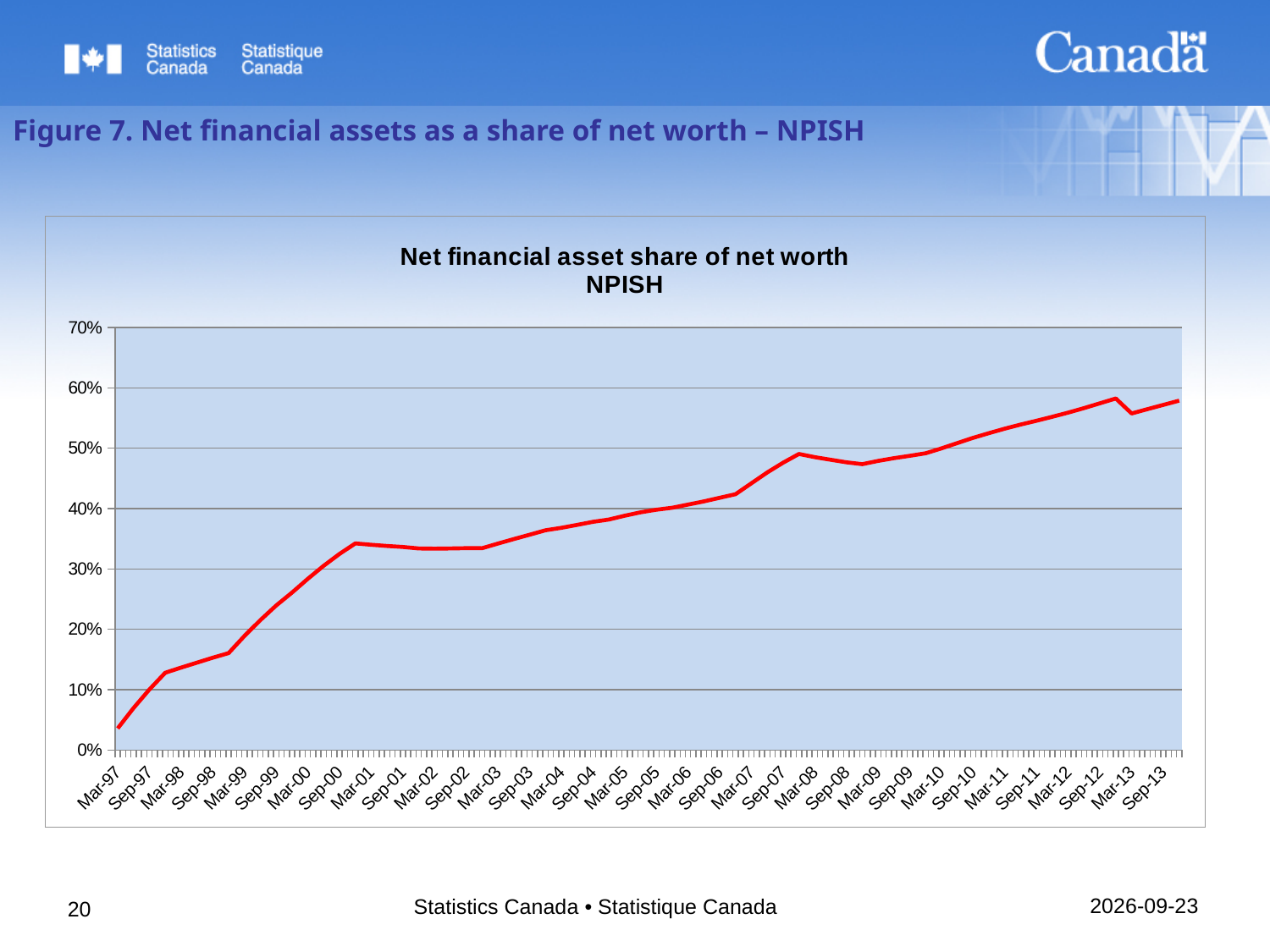
Is the value for Sep-13 greater or less than 60%? less Is the value for Mar-97 greater or less than 10%? less Which is larger, the value for Sep-12 or the value for Mar-13? Sep-12 What colour is the line in the chart? red Which period has the lowest net financial asset share of net worth? Mar-97 Is the value for Mar-01 greater or less than 30%? greater Which is larger, the value for Mar-01 or the value for Mar-99? Mar-01 Overall, does the net financial asset share of net worth rise or fall from Mar-97 to Sep-13? rise What is the title of the chart? Net financial asset share of net worth NPISH What kind of chart is shown on the slide? line chart